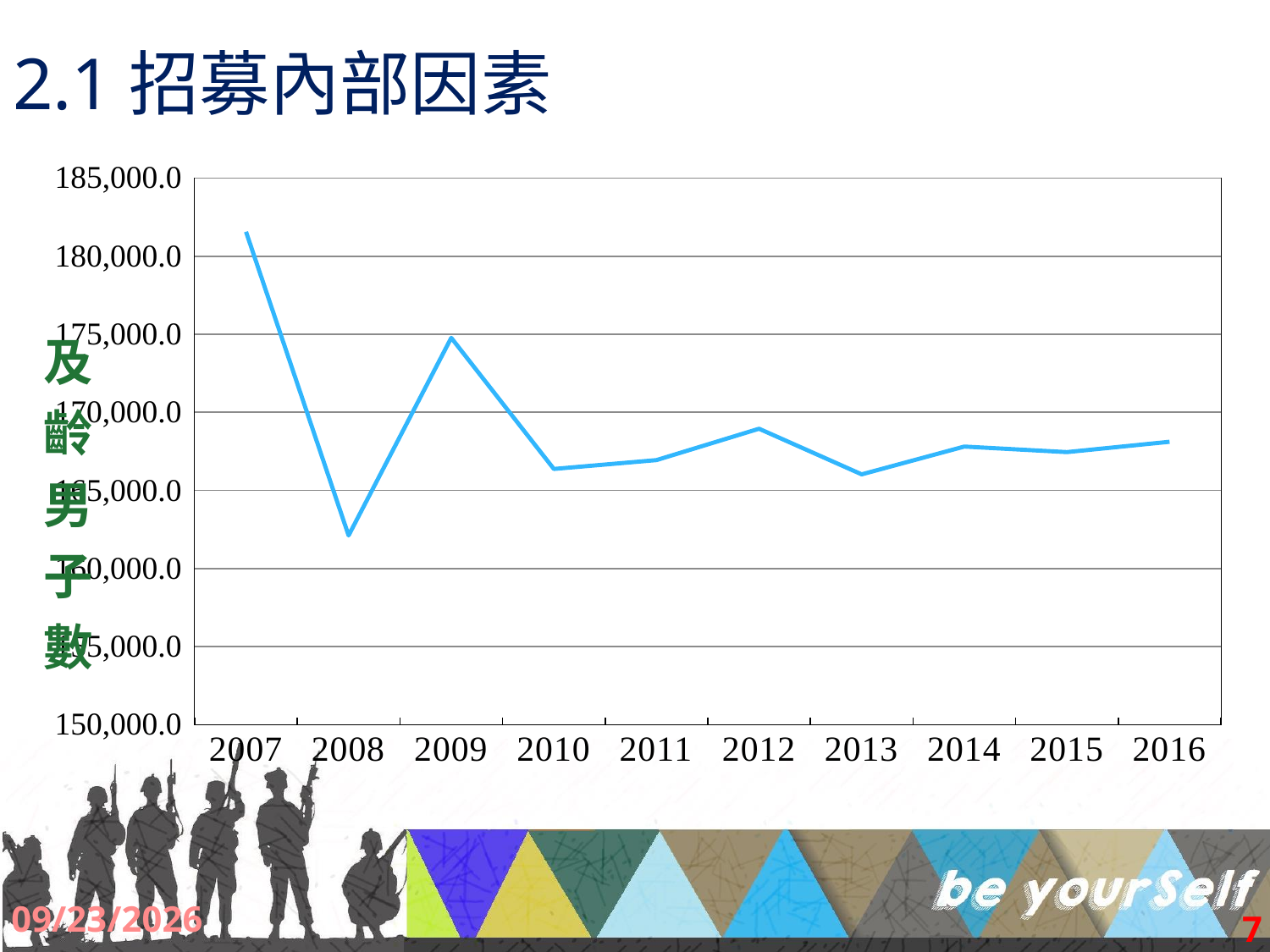
Which year has the lowest value in the chart? 2008 What is the title shown on the vertical axis of the chart? 及齡男子數 Which year has the larger value, 2012 or 2013? 2012 What kind of chart is shown on the slide? line chart Does the line rise or fall from 2007 to 2008? fall Is the value for 2007 greater or less than 180,000.0? greater Is the value for 2008 greater or less than 165,000.0? less Is the value for 2009 greater or less than 170,000.0? greater Which year has the highest value in the chart? 2007 Which year has the larger value, 2009 or 2010? 2009 How many years are plotted along the x axis of the chart? 10